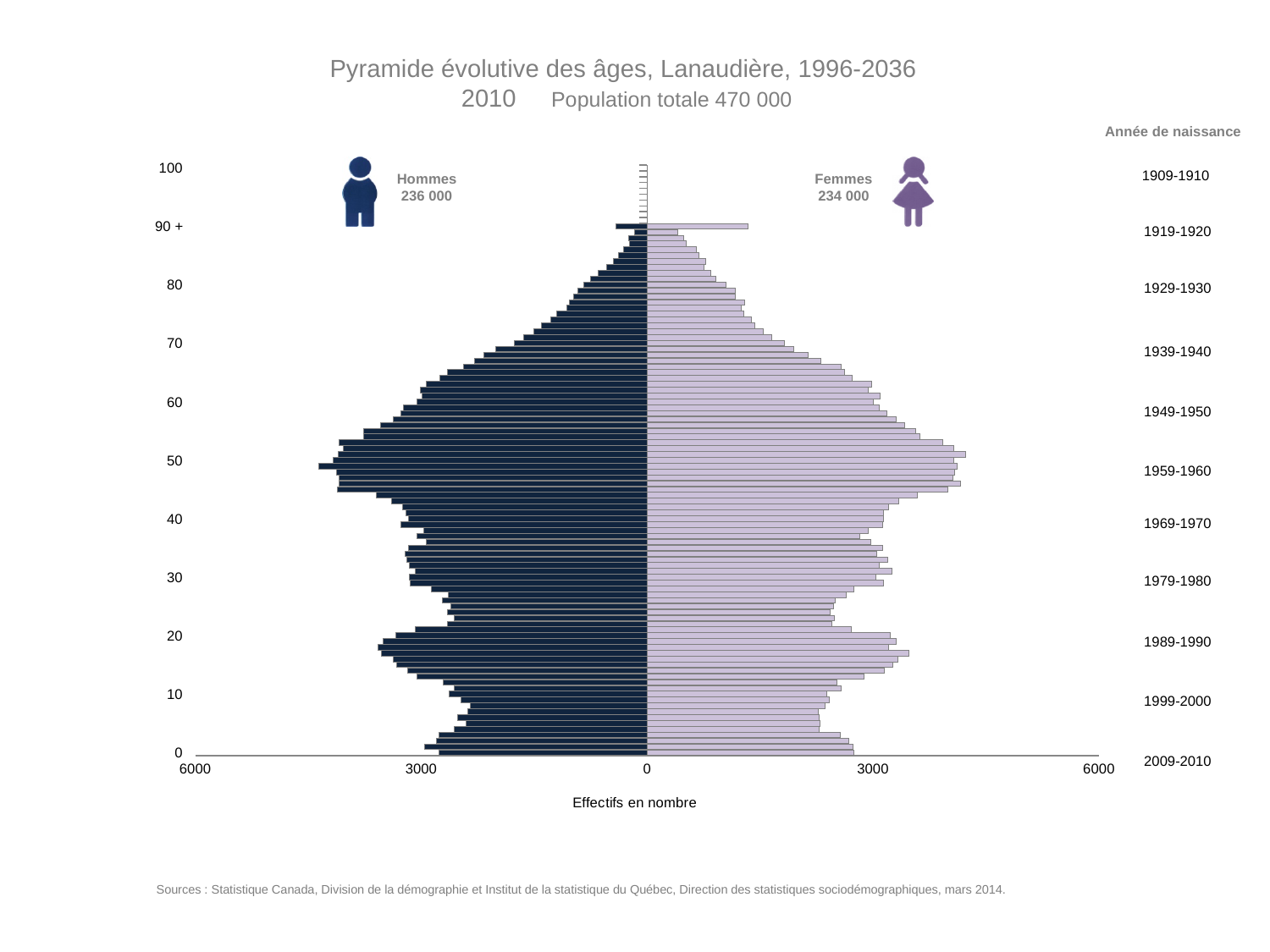
What is the total number of women (Femmes) shown on the chart? 234 000 Is the value for men at age 70 greater or less than 3000? less What is the difference between the number of Hommes and the number of Femmes? 2 000 For men, do the bar lengths rise or fall as age increases from 50 to 90+? fall Is the value for women at age 80 greater or less than 3000? less What is the total number of men (Hommes) shown on the chart? 236 000 What is the total population shown in the chart subtitle? 470 000 Is the value for men at age 50 greater or less than 3000? greater What is the label of the horizontal axis? Effectifs en nombre How many population groups (series) does the chart show? 2 What kind of chart is shown on the slide? bar chart Which group is larger, Hommes or Femmes? Hommes